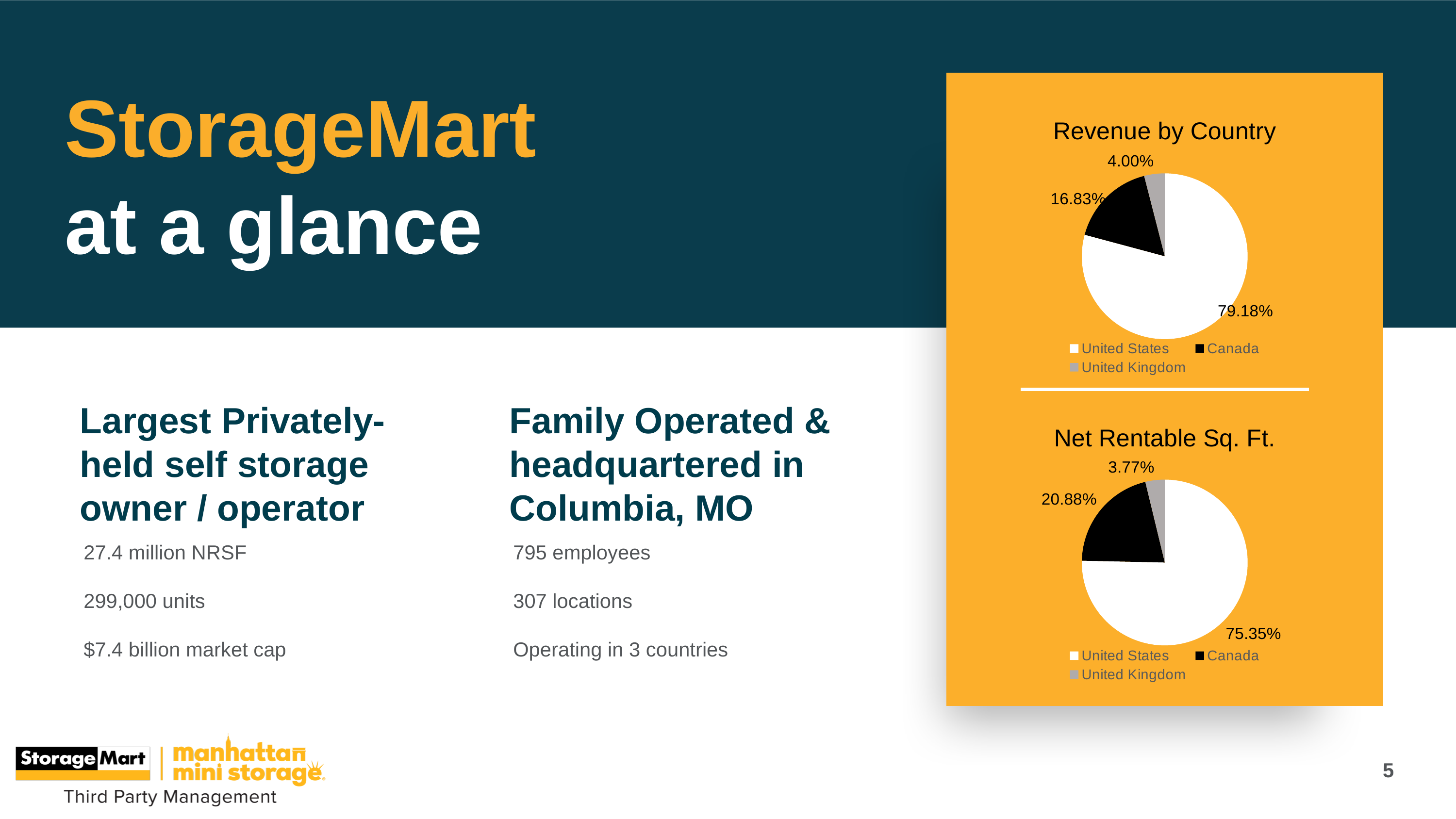
In the Net Rentable Sq. Ft. chart, what share does Canada account for? 20.88% In the Revenue by Country chart, what is the difference between the United States share and the Canada share? 62.35% In the Net Rentable Sq. Ft. chart, which country has the smallest share? United Kingdom In the Net Rentable Sq. Ft. chart, what share does the United States account for? 75.35% What type of chart is the Revenue by Country chart? Pie chart In the Revenue by Country chart, what share of revenue comes from the United Kingdom? 4.00% In the Revenue by Country chart, what share of revenue comes from Canada? 16.83% Is Canada's share larger in the Revenue by Country chart or in the Net Rentable Sq. Ft. chart? Net Rentable Sq. Ft. In the Net Rentable Sq. Ft. chart, what share does the United Kingdom account for? 3.77% In the Revenue by Country chart, what share of revenue comes from the United States? 79.18% In the Revenue by Country chart, which country has the largest share? United States How many countries does the legend of the Net Rentable Sq. Ft. chart list? 3